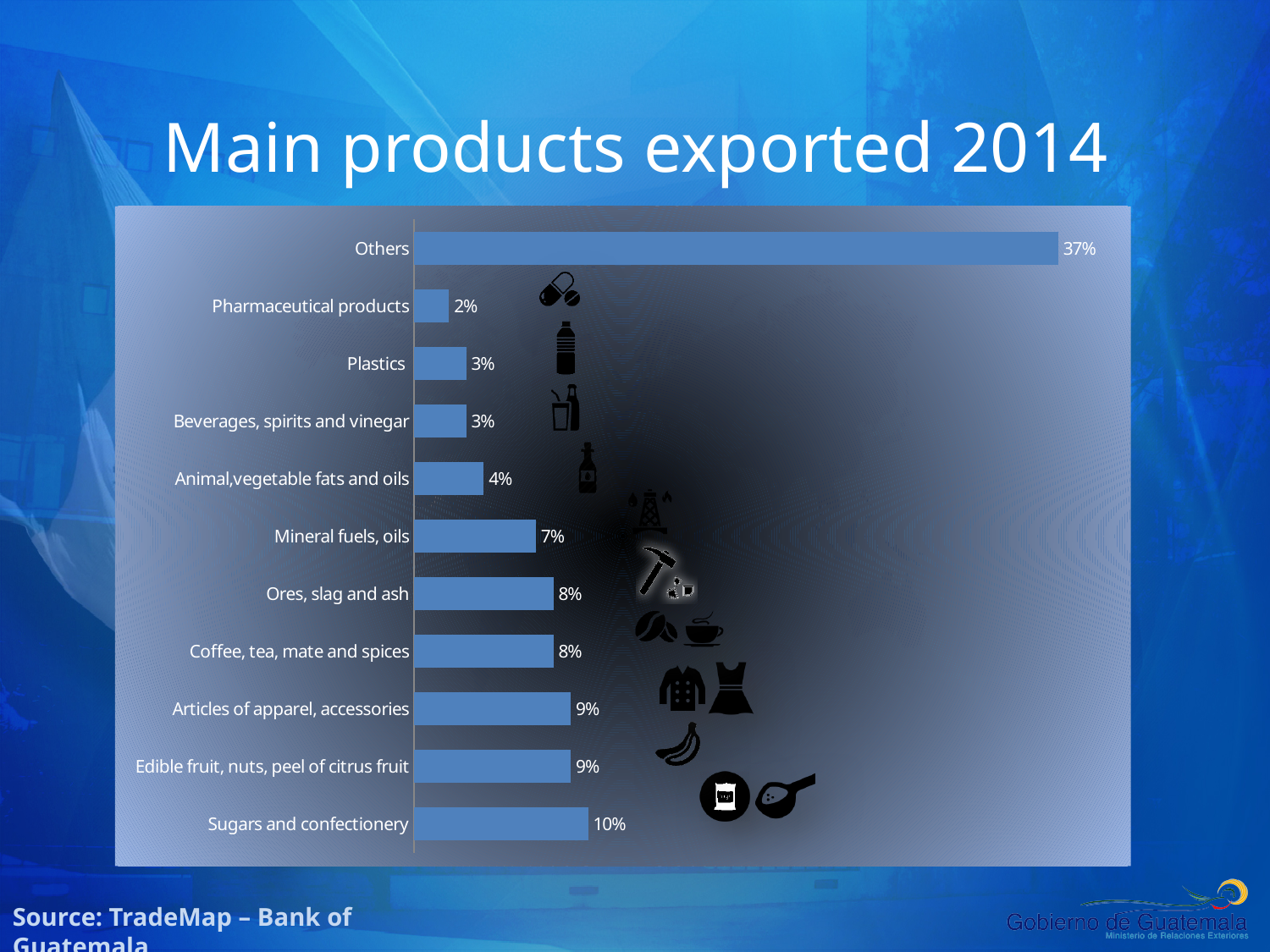
What is the value for Mineral fuels, oils? 7% Which category has the lowest value? Pharmaceutical products Which category has the highest value? Others What kind of chart is shown on the slide? bar chart What is the difference between the values for Others and Sugars and confectionery? 27% What is the value for Others? 37% What is the title of the slide? Main products exported 2014 What is the value for Pharmaceutical products? 2% How many categories are shown in the chart? 11 Which is larger, the value for Ores, slag and ash or the value for Animal,vegetable fats and oils? Ores, slag and ash What is the value for Sugars and confectionery? 10% What is the difference between the values for Articles of apparel, accessories and Plastics? 6%